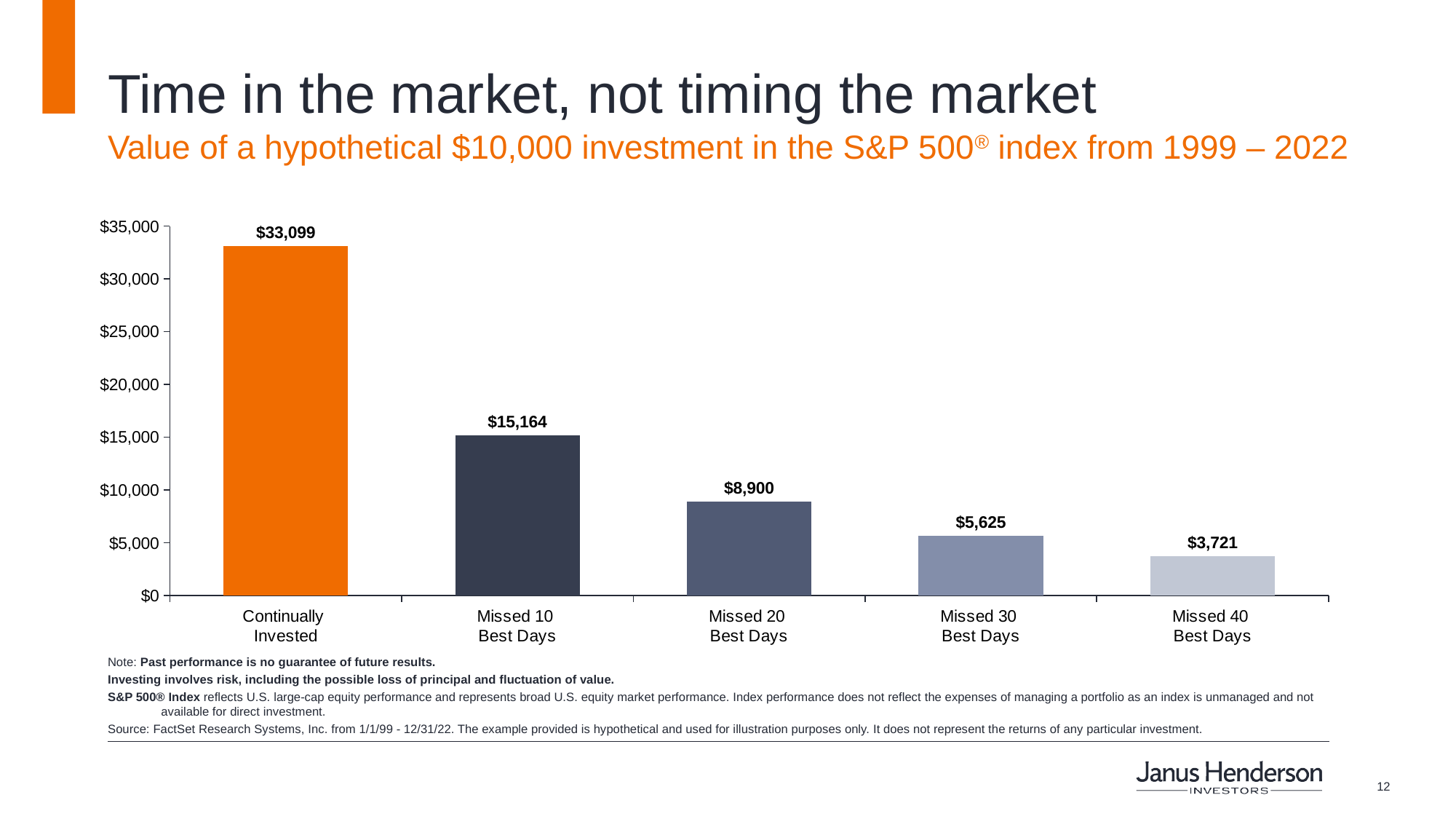
What is the difference between the values for Missed 30 Best Days and Missed 40 Best Days? $1,904 Which category has the highest value? Continually Invested What is the value for Continually Invested? $33,099 How many categories are shown on the x axis? 5 What kind of chart is shown on the slide? Bar chart Which category has the lowest value? Missed 40 Best Days Which is larger, the value for Missed 10 Best Days or Missed 20 Best Days? Missed 10 Best Days What is the difference between the values for Continually Invested and Missed 10 Best Days? $17,935 Do the values rise or fall moving from left to right along the x axis? Fall What is the value for Missed 20 Best Days? $8,900 What is the value for Missed 40 Best Days? $3,721 Is the value for Missed 30 Best Days greater or less than $10,000? less